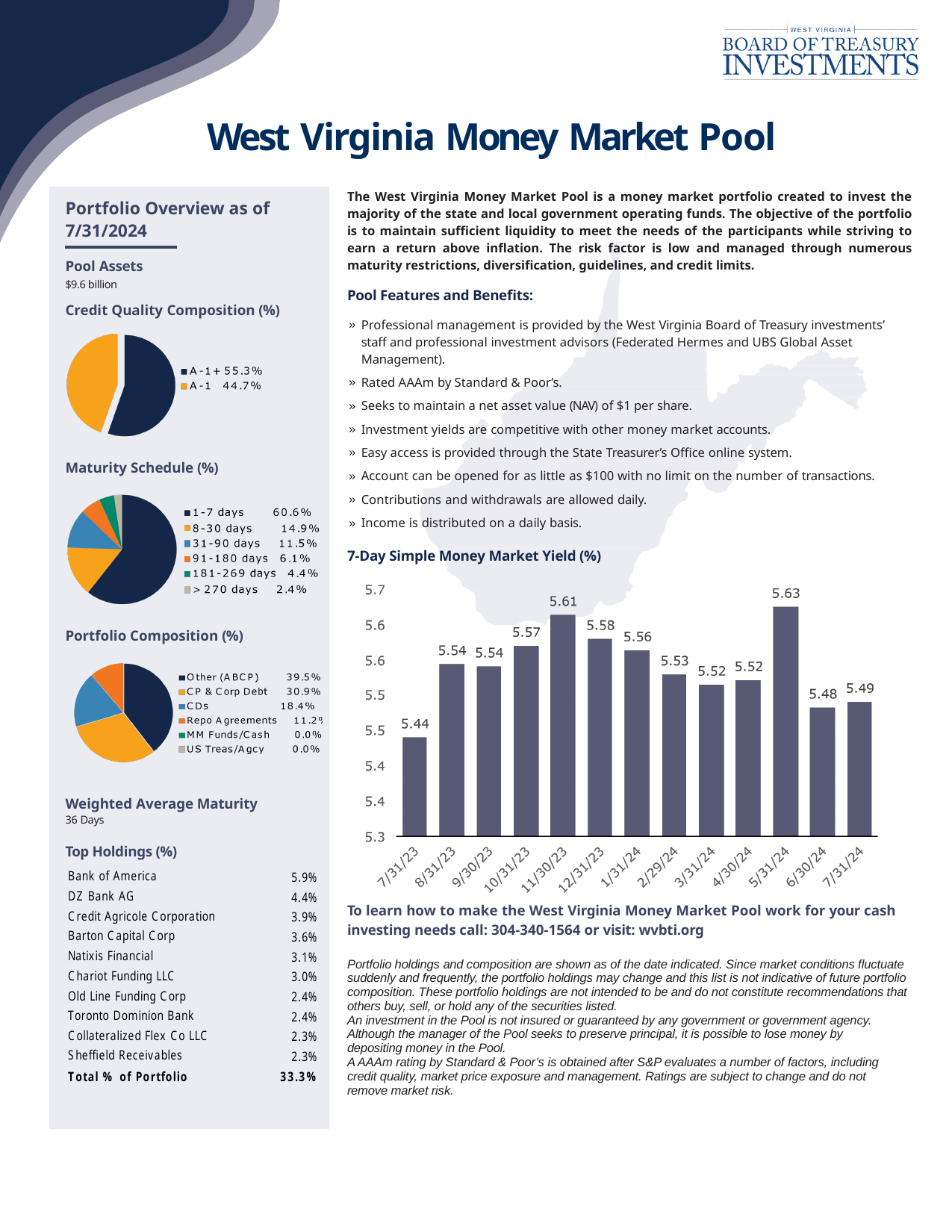
In the Credit Quality Composition (%) pie chart, what share is A-1+? 55.3% In the Portfolio Composition (%) pie chart, what is the value for CP & Corp Debt? 30.9% In the 7-Day Simple Money Market Yield (%) chart, which date has the lowest yield? 7/31/23 In the 7-Day Simple Money Market Yield (%) chart, which date has the highest yield? 5/31/24 In the 7-Day Simple Money Market Yield (%) chart, what is the difference between the values for 11/30/23 and 7/31/23? 0.17 How many categories does the legend of the Portfolio Composition (%) pie chart list? 6 How many bars are plotted in the 7-Day Simple Money Market Yield (%) chart? 13 In the 7-Day Simple Money Market Yield (%) chart, what is the value for 5/31/24? 5.63 In the Maturity Schedule (%) pie chart, what is the value for 31-90 days? 11.5% What kind of chart is the 7-Day Simple Money Market Yield (%) chart? bar chart In the 7-Day Simple Money Market Yield (%) chart, which is larger, the value for 6/30/24 or the value for 7/31/24? 7/31/24 In the Maturity Schedule (%) pie chart, which category has the largest share? 1-7 days